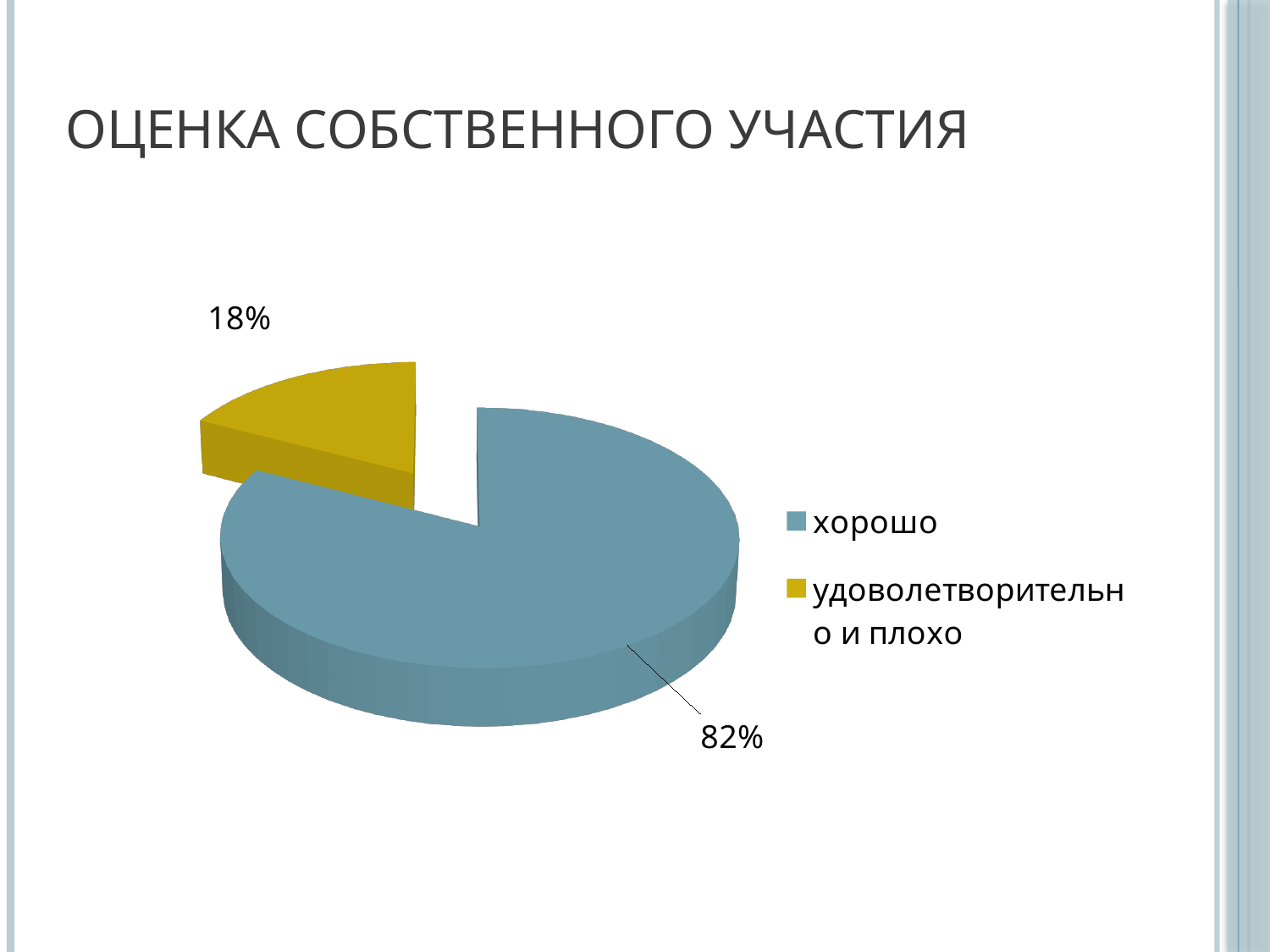
What colour is the "хорошо" slice? blue Which category has the largest slice of the pie? хорошо What kind of chart is shown on the slide? pie chart What is the difference in percentage points between the "хорошо" slice and the "удоволетворительно и плохо" slice? 64 How many entries does the legend list? 2 How many slices does the pie chart have? 2 What share of the pie does the "хорошо" slice represent? 82% Which category has the smallest slice of the pie? удоволетворительно и плохо What is the title of the slide? ОЦЕНКА СОБСТВЕННОГО УЧАСТИЯ What share of the pie does the "удоволетворительно и плохо" slice represent? 18% Which is larger: the "хорошо" slice or the "удоволетворительно и плохо" slice? хорошо